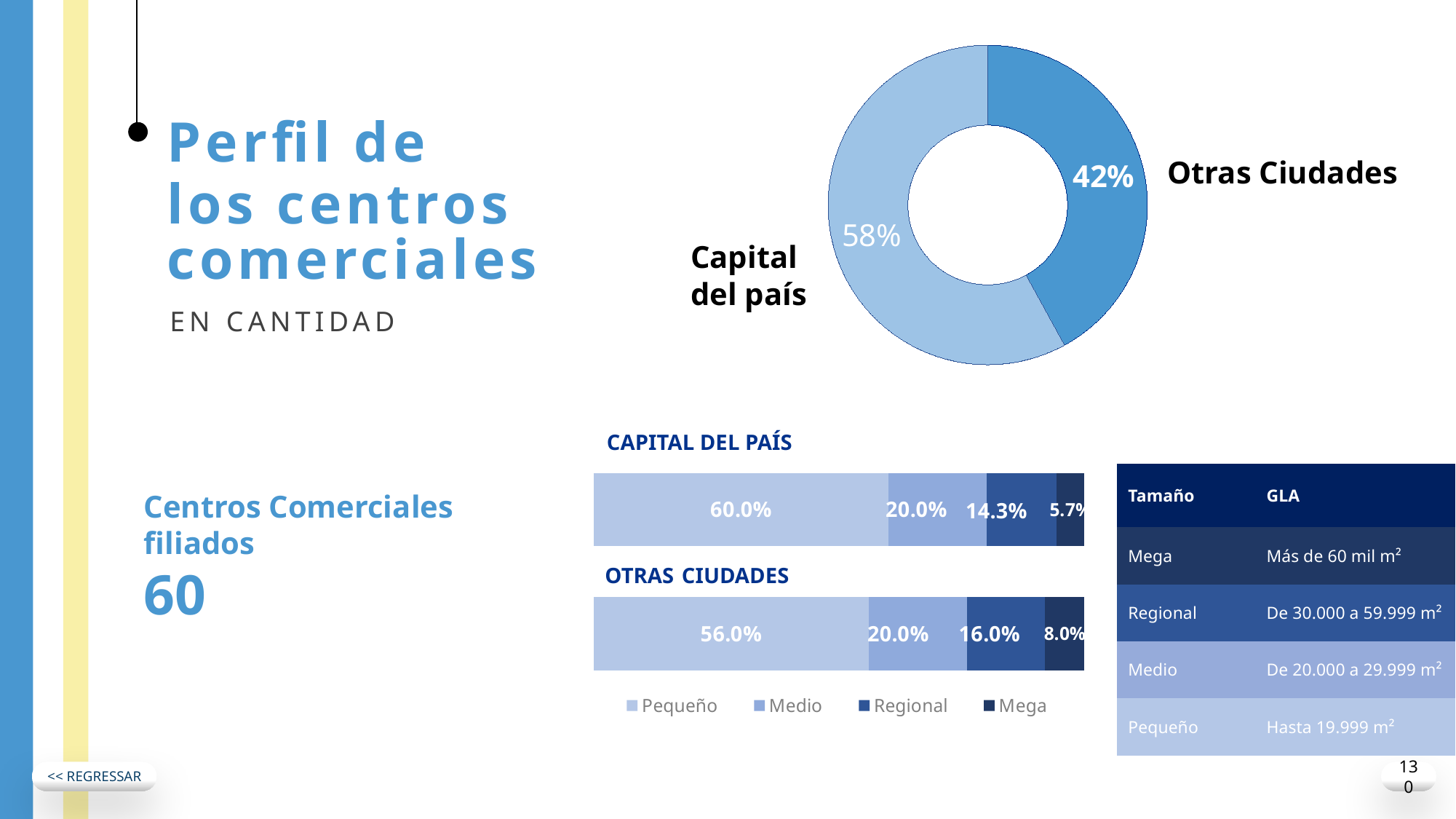
In the donut chart at the top, how many segments are shown? 2 What is the difference between the Pequeño values in the CAPITAL DEL PAÍS bar and the OTRAS CIUDADES bar? 4.0% In the donut chart at the top, what share is labelled for Otras Ciudades? 42% What kind of chart is shown at the top of the slide? Donut chart In the CAPITAL DEL PAÍS stacked bar, what is the value for Pequeño? 60.0% In the CAPITAL DEL PAÍS stacked bar, what is the value for Mega? 5.7% In the donut chart at the top, which segment is larger, Capital del país or Otras Ciudades? Capital del país How many series does the legend below the stacked bars list? 4 In the OTRAS CIUDADES stacked bar, what is the value for Regional? 16.0% In the OTRAS CIUDADES stacked bar, which category has the smallest value? Mega In the donut chart at the top, what share is labelled for Capital del país? 58% What kind of chart are the CAPITAL DEL PAÍS and OTRAS CIUDADES charts? Stacked bar chart